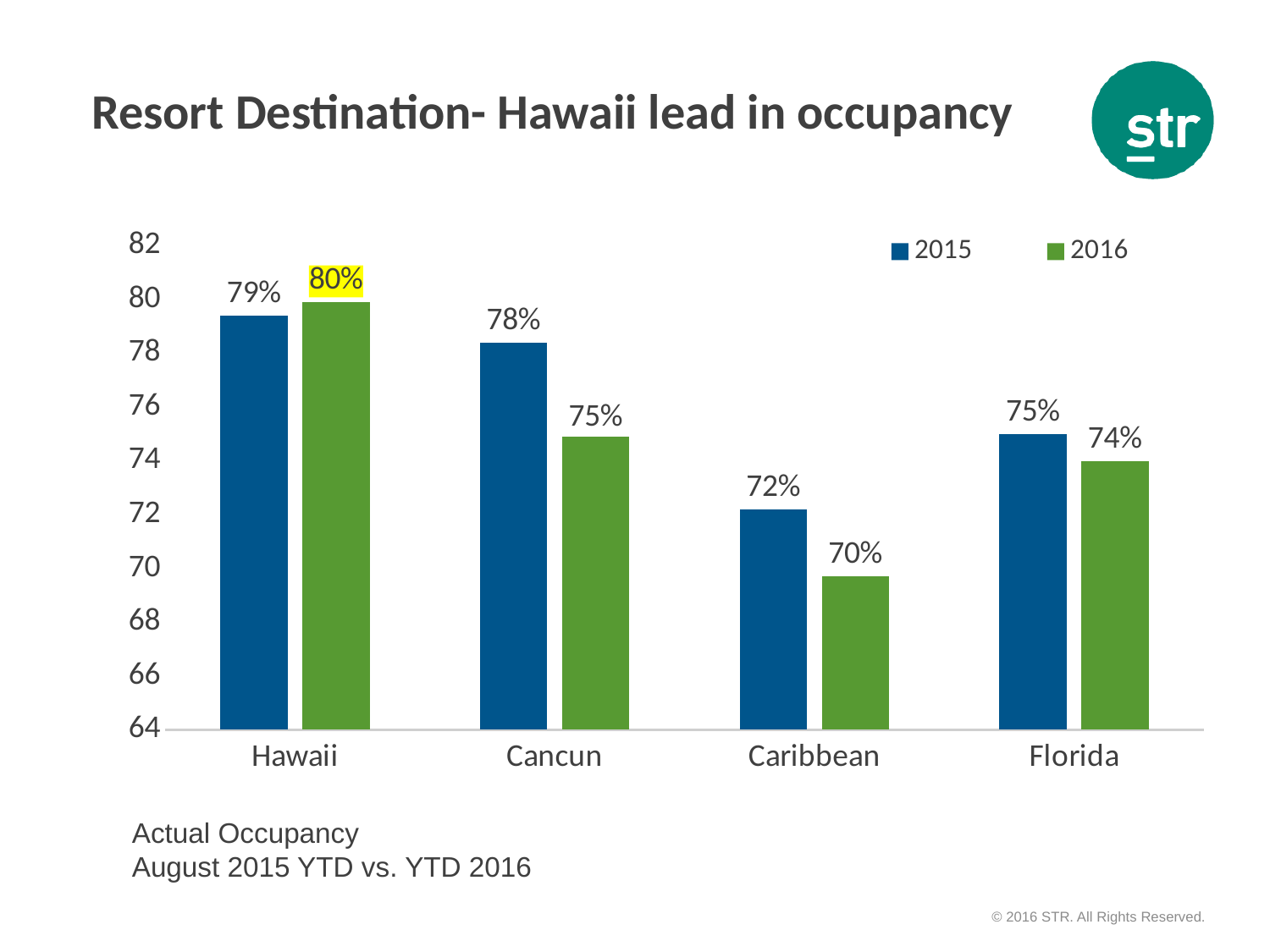
What is the 2015 occupancy value for Florida? 75% Which destination has the highest 2016 occupancy? Hawaii What is the 2016 occupancy value for Caribbean? 70% What is the difference between the 2015 and 2016 occupancy values for Cancun? 3% How many destinations are shown on the x axis? 4 Which is larger, the 2015 occupancy for Florida or the 2016 occupancy for Florida? 2015 Which destination has the lowest 2015 occupancy? Caribbean What is the 2015 occupancy value for Cancun? 78% How many series does the legend list? 2 What kind of chart is shown on the slide? bar chart What is the 2016 occupancy value for Hawaii? 80% Is the 2016 occupancy value for Caribbean greater or less than 72? less